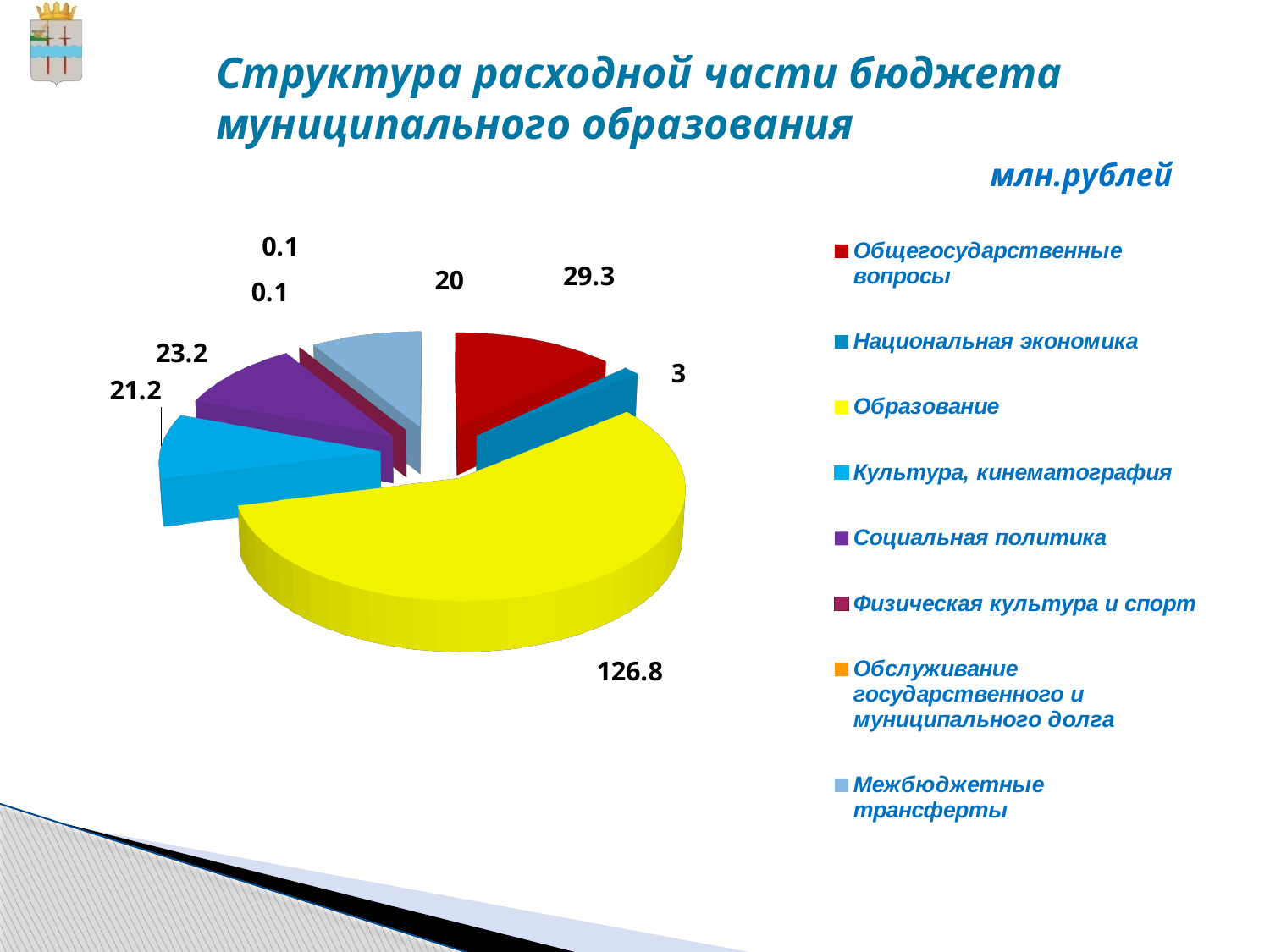
In what units are the values on the chart given? млн.рублей What is the value for Общегосударственные вопросы? 29.3 How many categories does the legend list? 8 What is the value for Межбюджетные трансферты? 20 What is the value for Национальная экономика? 3 What is the smallest value shown on the chart? 0.1 What kind of chart is shown on the slide? pie chart Which is larger, the value for Социальная политика or the value for Культура, кинематография? Социальная политика What is the difference between the values for Общегосударственные вопросы and Национальная экономика? 26.3 What is the value for Физическая культура и спорт? 0.1 Which category has the largest slice of the pie? Образование What is the value for Образование? 126.8